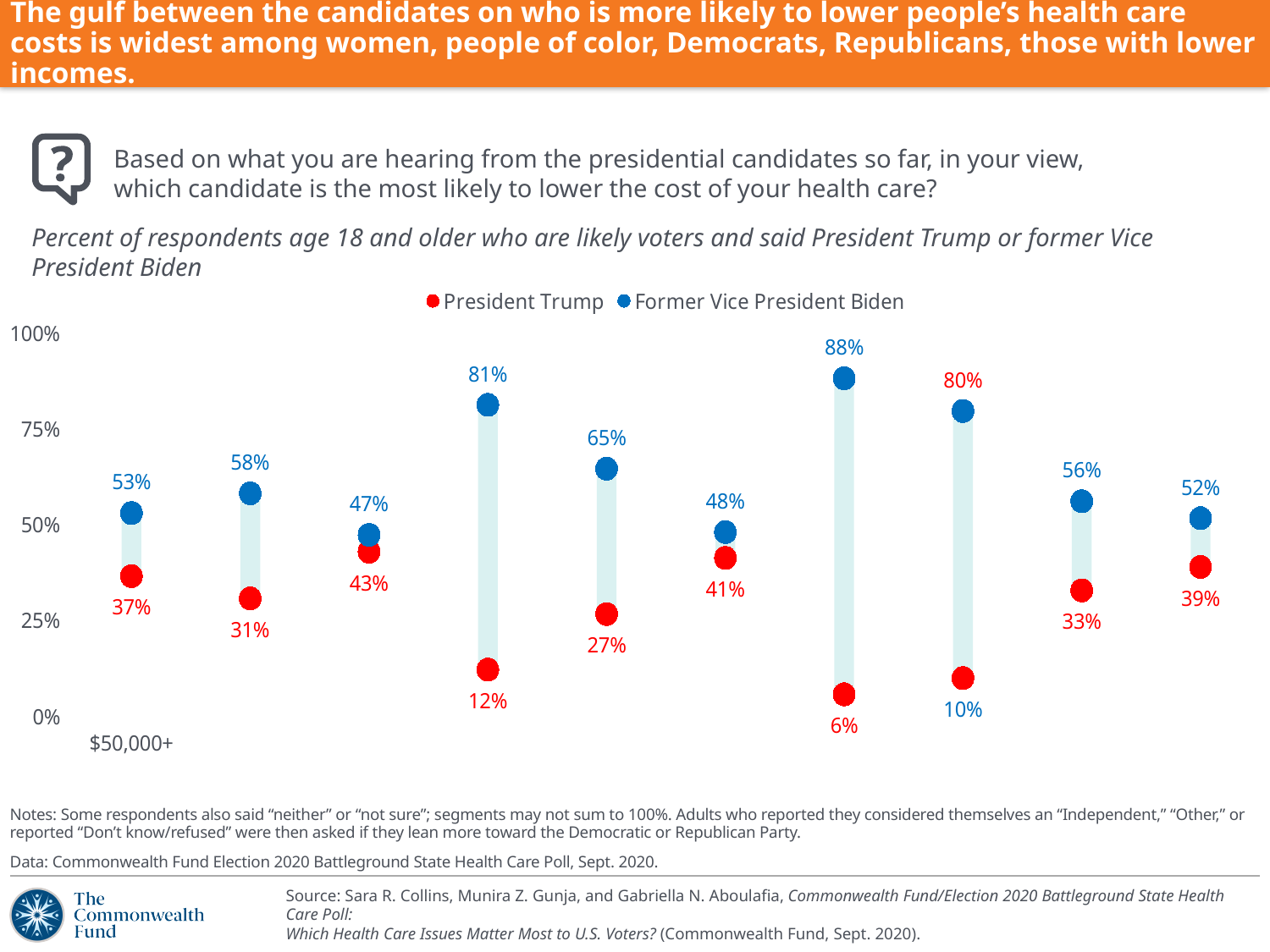
How many groups (pairs of dots) are plotted in the chart? 10 How many series does the legend list? 2 In the group where 88% said Biden and 6% said Trump, what is the difference between the two values? 82 percentage points In the group where 81% said Biden and 12% said Trump, what is the difference between the two values? 69 percentage points What are the two series named in the legend? President Trump and Former Vice President Biden In the rightmost group, which candidate has the larger value, Trump at 39% or Biden at 52%? Former Vice President Biden In the leftmost group, what percent said Former Vice President Biden? 53% What is the lowest value shown for President Trump? 6% What is the highest value shown for Former Vice President Biden? 88% In the leftmost group, what percent said President Trump? 37% Which colour represents President Trump in the chart? Red In the group where 81% said Former Vice President Biden, what percent said President Trump? 12%